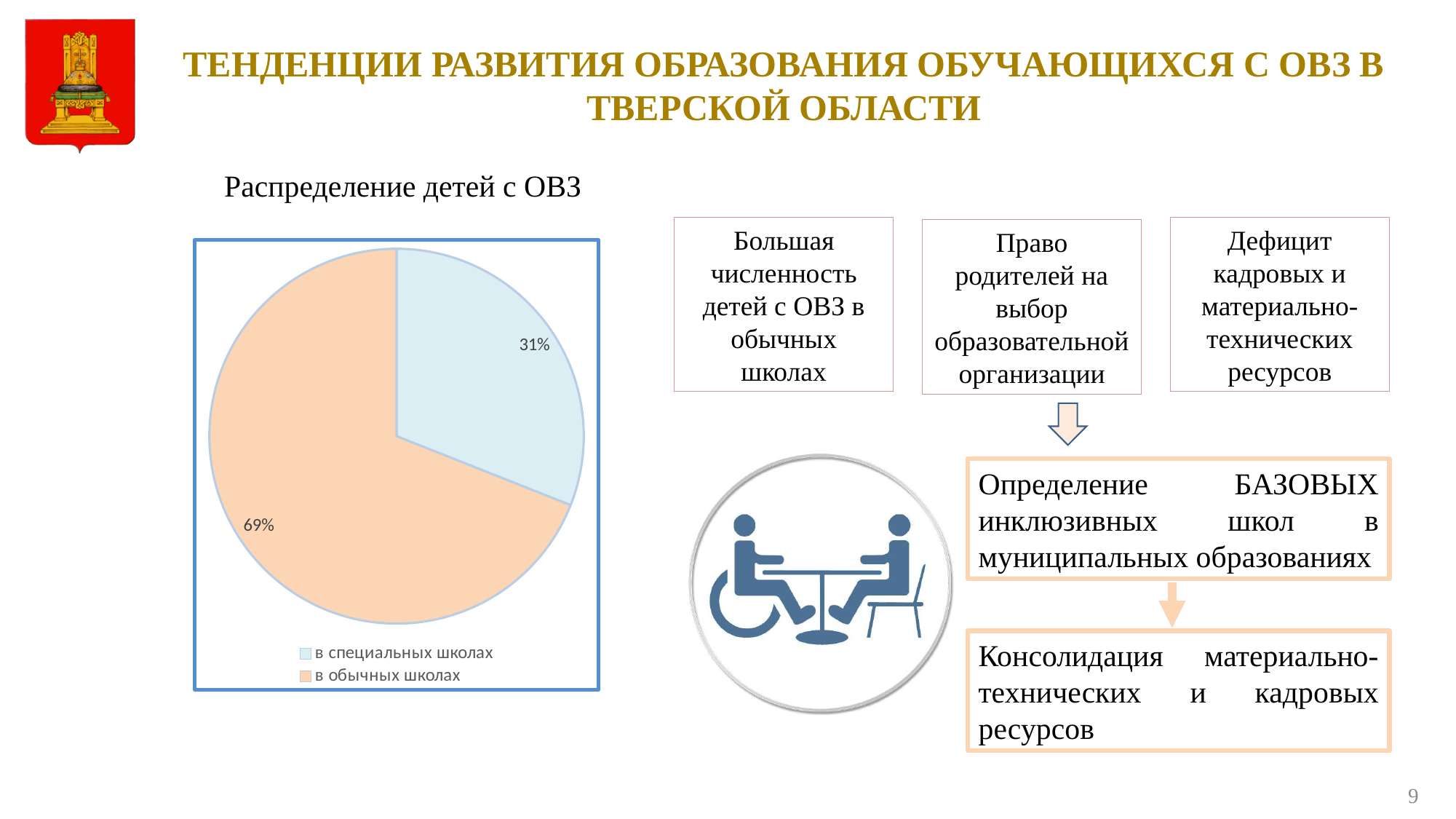
What is the title of the chart? Распределение детей с ОВЗ What share of children with OVZ are in regular schools (в обычных школах)? 69% What is the difference in percentage points between the share in regular schools and the share in special schools? 38 What is the total of the two slices shown in the pie chart? 100% What kind of chart is shown on the slide? pie chart What share of children with OVZ are in special schools (в специальных школах)? 31% What colour is the slice for 'в обычных школах'? orange (peach) How many entries does the legend list? 2 Which is larger: the share in special schools or the share in regular schools? в обычных школах Which category has the smallest slice of the pie? в специальных школах How many categories does the pie chart have? 2 Which category has the largest slice of the pie? в обычных школах